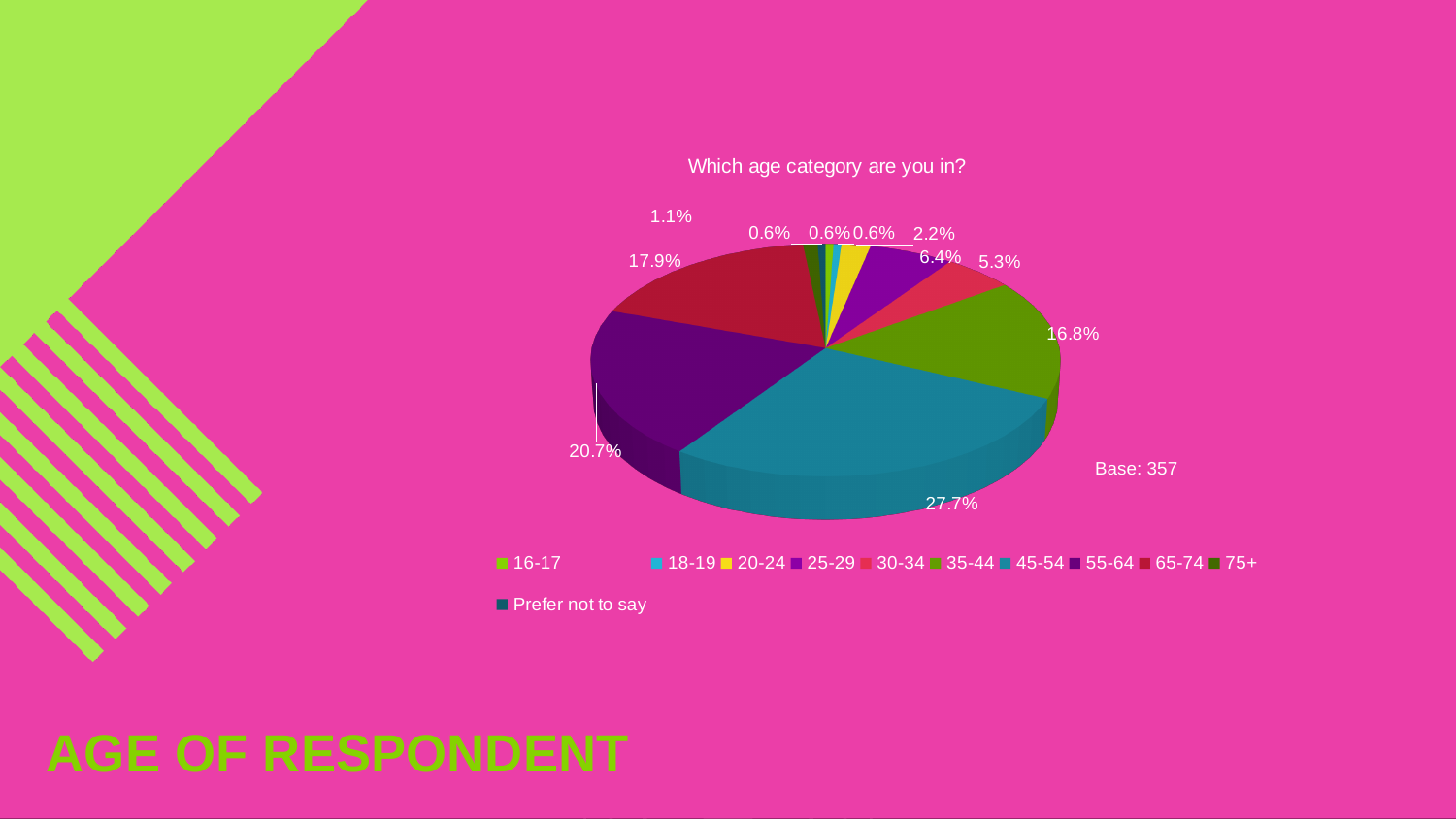
How many age categories does the legend list? 11 What percentage of respondents are aged 45-54? 27.7% What percentage of respondents are aged 25-29? 6.4% What kind of chart is shown on the slide? Pie chart Which age category has the largest share of respondents? 45-54 What is the title of the chart? Which age category are you in? Which has a larger share, the 25-29 category or the 30-34 category? 25-29 What percentage of respondents are aged 55-64? 20.7% What is the base (number of respondents) shown on the chart? 357 What percentage of respondents are aged 35-44? 16.8% What is the difference in percentage points between the 45-54 and 55-64 age categories? 7.0 percentage points What percentage of respondents are aged 65-74? 17.9%